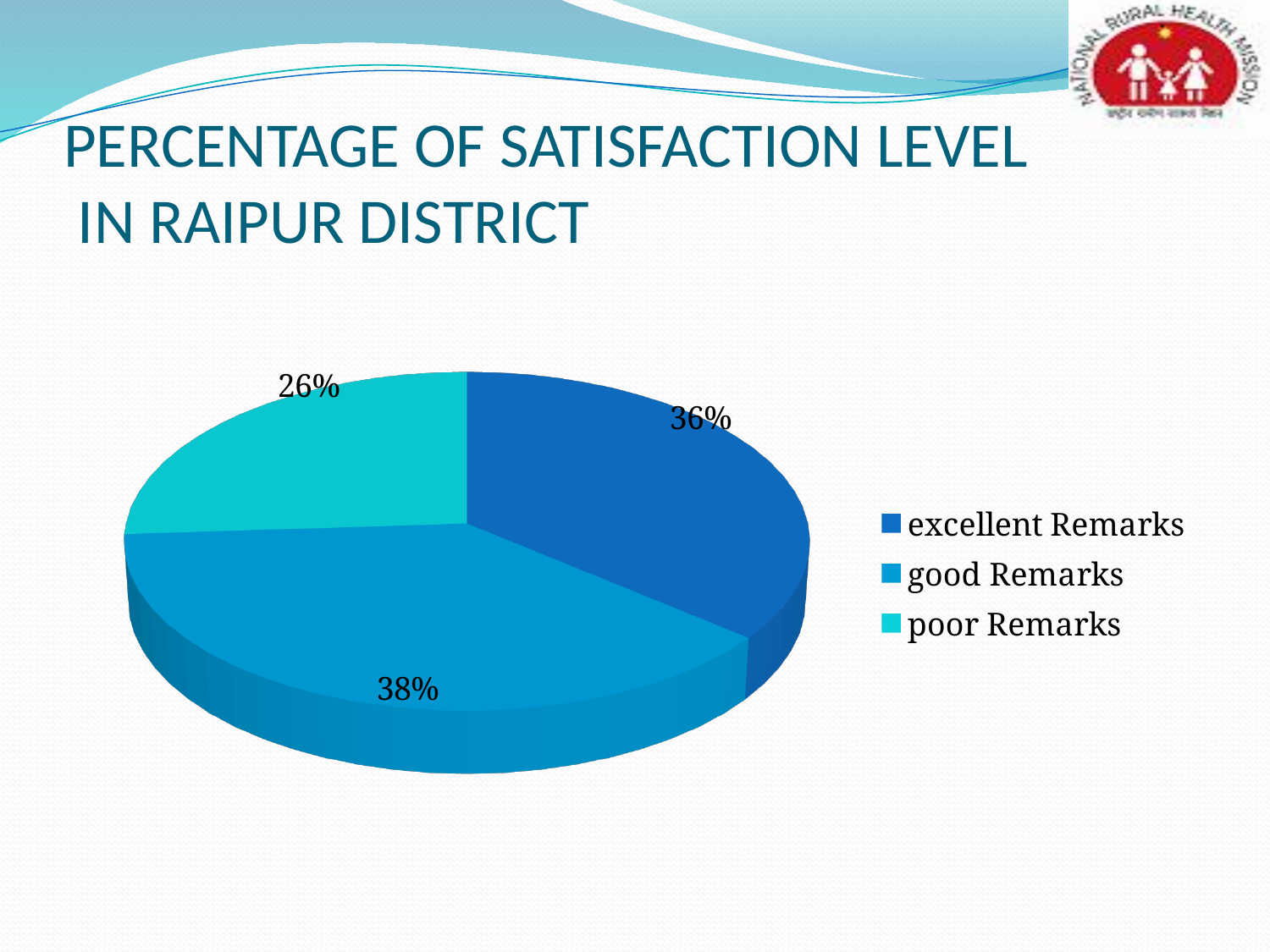
What is the title of the slide containing the chart? PERCENTAGE OF SATISFACTION LEVEL IN RAIPUR DISTRICT What kind of chart is shown on the slide? pie chart Which category has the smallest share of the pie? poor Remarks What percentage of the pie is labelled for good Remarks? 38% What is the difference in percentage points between excellent Remarks and poor Remarks? 10 Which is larger, the share for excellent Remarks or the share for poor Remarks? excellent Remarks Which category has the largest share of the pie? good Remarks How many entries does the legend list? 3 What is the difference in percentage points between good Remarks and poor Remarks? 12 What percentage of the pie is labelled for poor Remarks? 26% What percentage of the pie is labelled for excellent Remarks? 36% How many slices does the pie chart have? 3